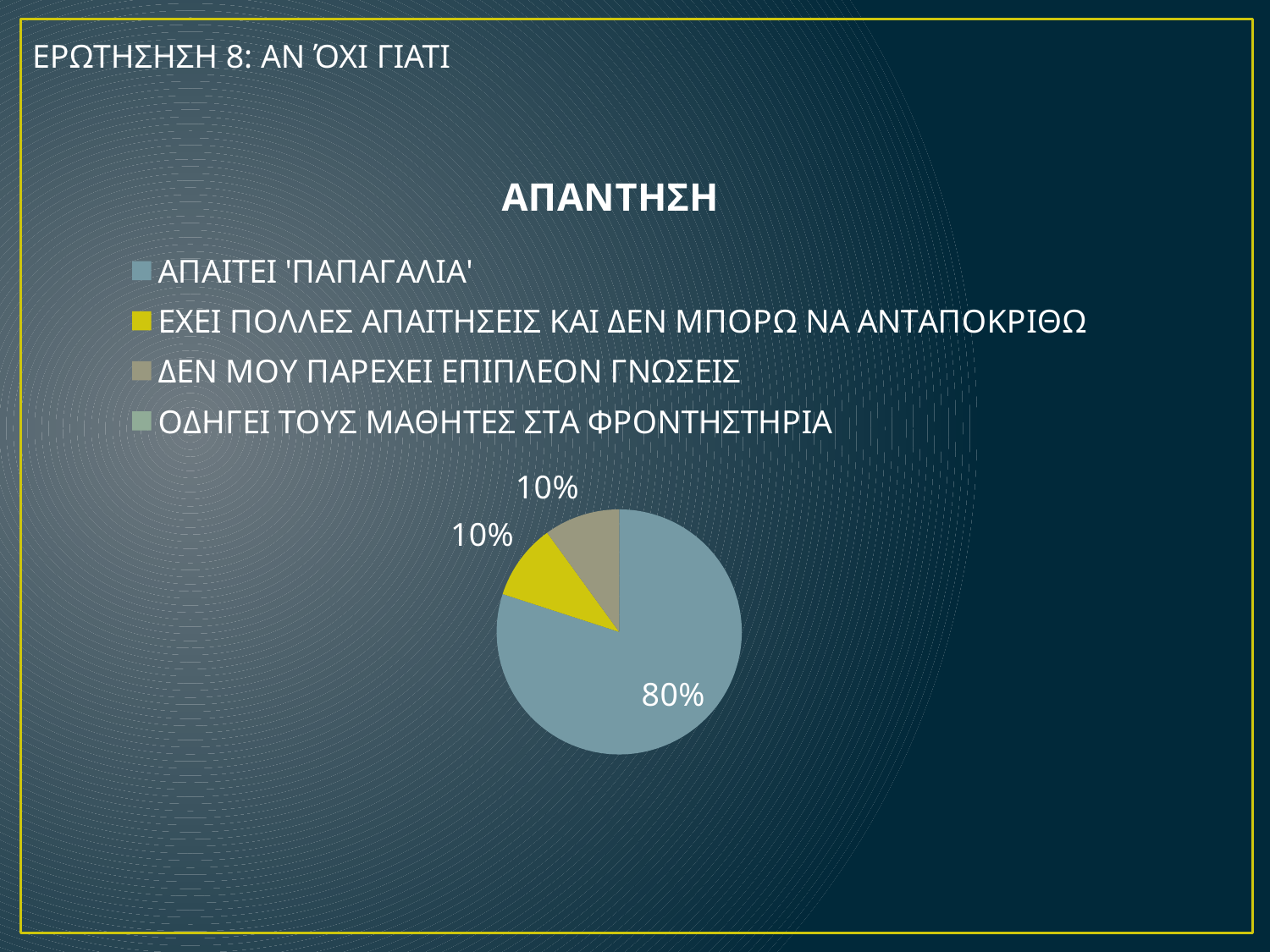
Which is larger: the share for ΑΠΑΙΤΕΙ 'ΠΑΠΑΓΑΛΙΑ' or the share for ΕΧΕΙ ΠΟΛΛΕΣ ΑΠΑΙΤΗΣΕΙΣ ΚΑΙ ΔΕΝ ΜΠΟΡΩ ΝΑ ΑΝΤΑΠΟΚΡΙΘΩ? ΑΠΑΙΤΕΙ 'ΠΑΠΑΓΑΛΙΑ' What percentage is shown for ΑΠΑΙΤΕΙ 'ΠΑΠΑΓΑΛΙΑ'? 80% How many slices with a printed percentage label are visible in the pie? 3 What share of the pie does the yellow slice represent? 10% What is the difference between the share for ΑΠΑΙΤΕΙ 'ΠΑΠΑΓΑΛΙΑ' and the share for ΔΕΝ ΜΟΥ ΠΑΡΕΧΕΙ ΕΠΙΠΛΕΟΝ ΓΝΩΣΕΙΣ? 70% What percentage is shown for ΔΕΝ ΜΟΥ ΠΑΡΕΧΕΙ ΕΠΙΠΛΕΟΝ ΓΝΩΣΕΙΣ? 10% Which legend entry is shown in yellow? ΕΧΕΙ ΠΟΛΛΕΣ ΑΠΑΙΤΗΣΕΙΣ ΚΑΙ ΔΕΝ ΜΠΟΡΩ ΝΑ ΑΝΤΑΠΟΚΡΙΘΩ What is the title of the chart? ΑΠΑΝΤΗΣΗ Which category has the largest share of the pie? ΑΠΑΙΤΕΙ 'ΠΑΠΑΓΑΛΙΑ' What percentage is shown for ΕΧΕΙ ΠΟΛΛΕΣ ΑΠΑΙΤΗΣΕΙΣ ΚΑΙ ΔΕΝ ΜΠΟΡΩ ΝΑ ΑΝΤΑΠΟΚΡΙΘΩ? 10% How many entries does the legend list? 4 What kind of chart is shown on the slide? pie chart